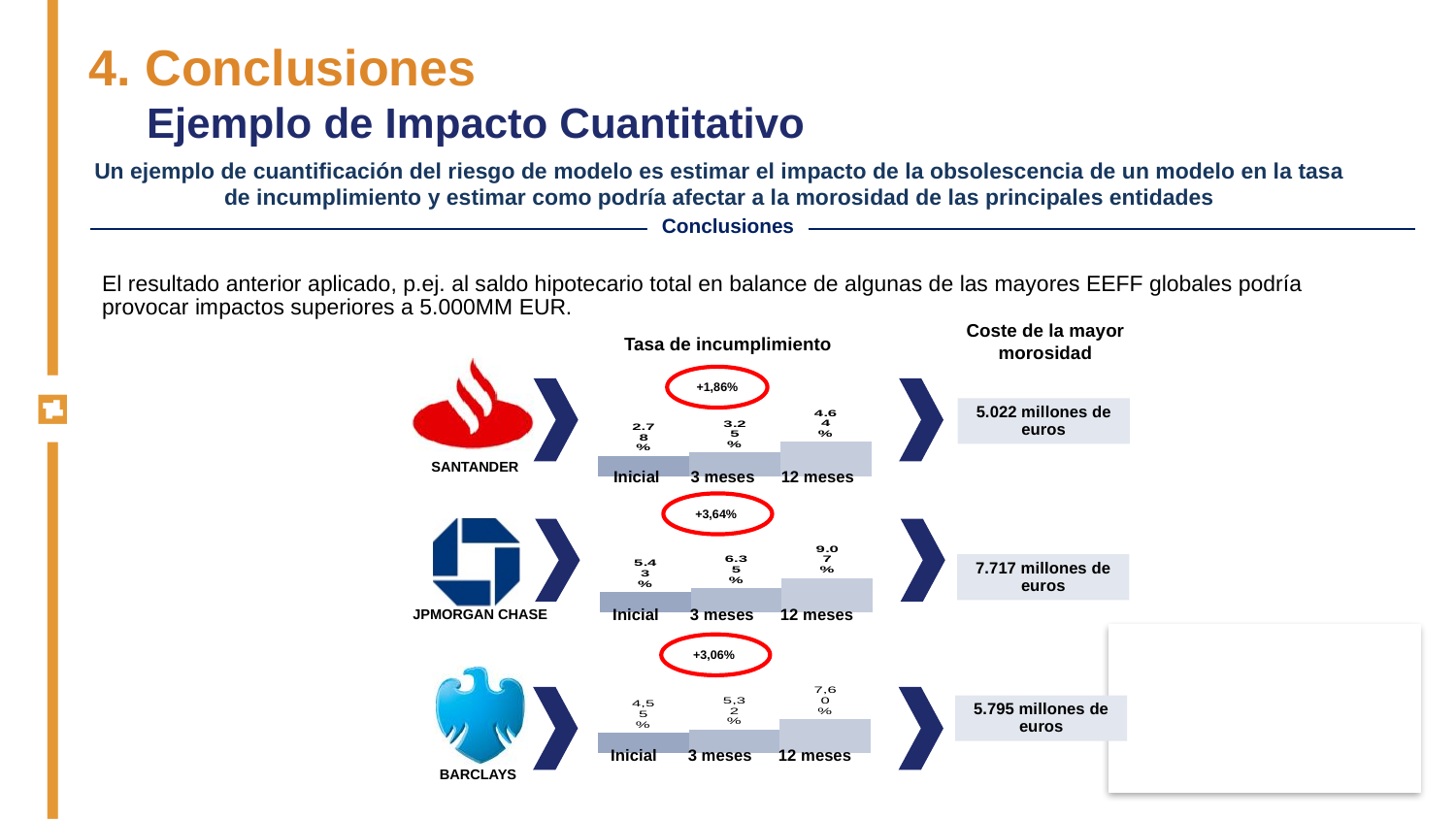
In the Santander chart, what is the difference between the 12 meses value and the Inicial value? 1.86% In the JPMorgan Chase chart, what is the value for 12 meses? 9.07% In the JPMorgan Chase chart, what is the difference between the 12 meses value and the Inicial value? 3.64% In the Barclays chart, which category has the highest value? 12 meses How many categories does the Santander chart show? 3 What kind of chart is used for the JPMorgan Chase data? Bar chart In the Santander chart, what is the value for Inicial? 2.78% In the JPMorgan Chase chart, what is the value for 3 meses? 6.35% In the Barclays chart, what is the value for Inicial? 4,55% In the Santander chart, what is the value for 12 meses? 4.64% In the Barclays chart, which is larger, the value for 3 meses or the value for 12 meses? 12 meses In the JPMorgan Chase chart, which category has the lowest value? Inicial